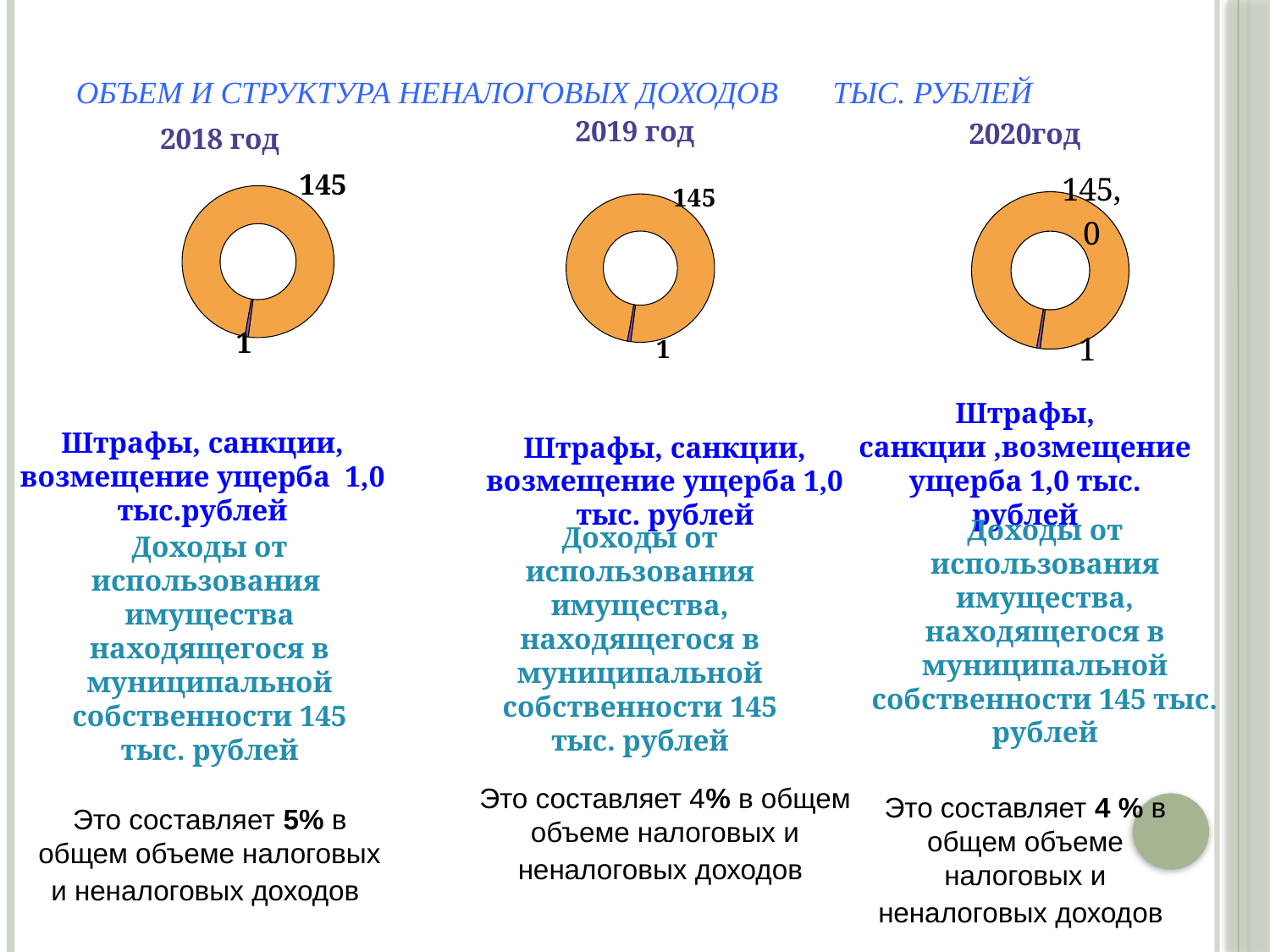
In the 2019 год chart, what is the value of the larger slice? 145 In the 2020год chart, what is the value of the smaller slice? 1 In the 2018 год chart, what is the value of the smaller slice? 1 How many slices does the 2019 год chart have? 2 In the 2019 год chart, which slice is larger: the one labelled 145 or the one labelled 1? 145 In the 2020год chart, what value is printed on the larger slice? 145,0 In the 2019 год chart, what is the total of the two slices (145 and 1)? 146 What colour is the larger slice in the 2020год chart? orange In the 2018 год chart, what is the smallest slice value? 1 In the 2018 год chart, what is the difference between the larger slice (145) and the smaller slice (1)? 144 What kind of chart is used for the 2018 год chart? doughnut (pie) chart In the 2018 год chart, what is the value of the larger slice? 145